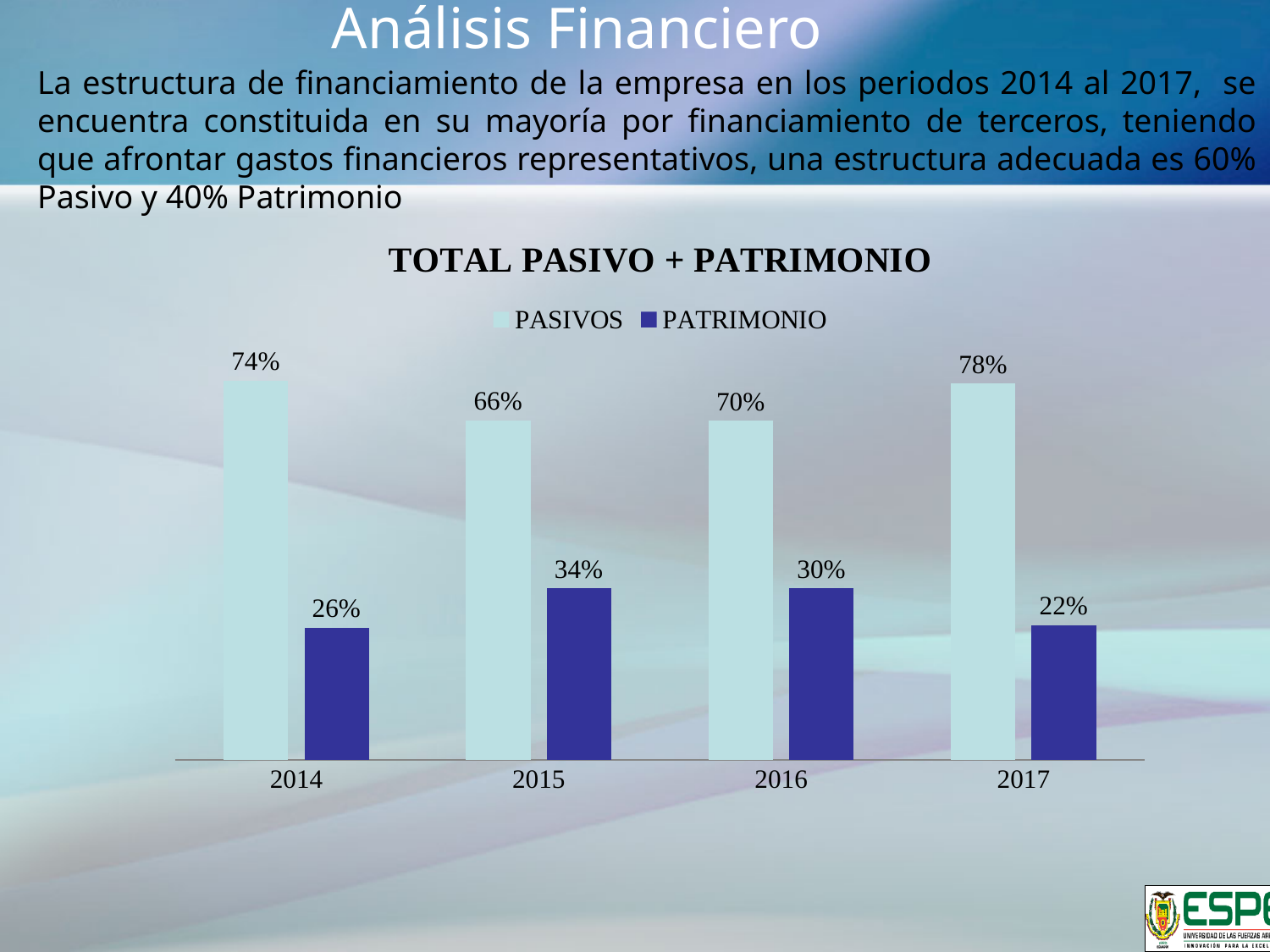
What is the difference between the PASIVOS and PATRIMONIO values in 2016? 40% In which year is the PASIVOS value highest? 2017 What is the PATRIMONIO value for 2017? 22% Does the PATRIMONIO value rise or fall from 2015 to 2017? Fall How many years are shown on the x axis? 4 What kind of chart is shown on the slide? Bar chart How many series does the legend list? 2 Which is larger in 2015, the PASIVOS value or the PATRIMONIO value? PASIVOS In which year is the PATRIMONIO value lowest? 2017 What is the title of the chart? TOTAL PASIVO + PATRIMONIO What is the PATRIMONIO value for 2015? 34% What is the PASIVOS value for 2014? 74%